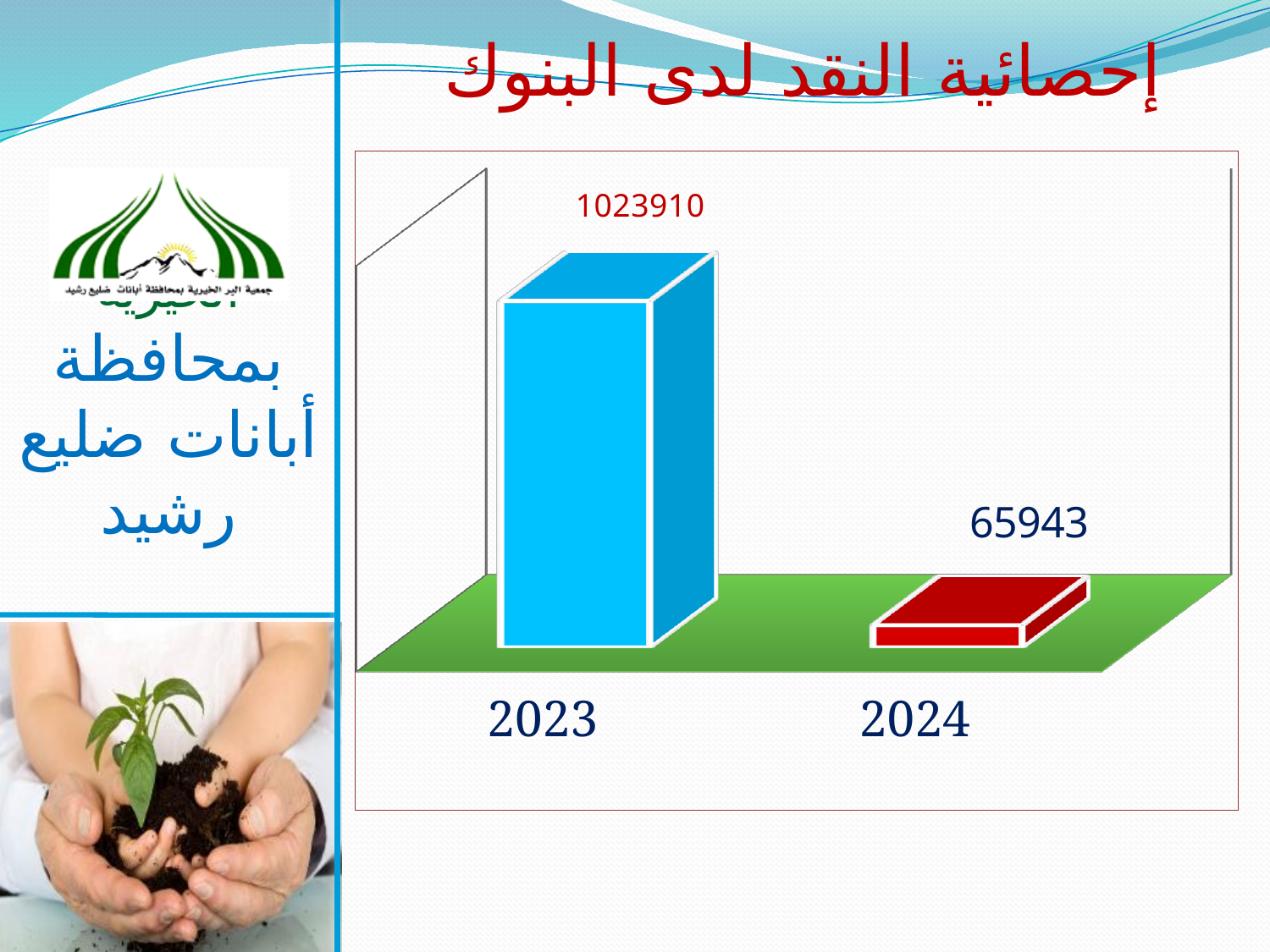
Do the values rise or fall from 2023 to 2024? fall What kind of chart is shown on the slide? bar chart Which year has the lowest value? 2024 What is the difference between the values for 2023 and 2024? 957967 Which is larger, the value for 2023 or the value for 2024? 2023 What is the value for 2024? 65943 How many categories are shown on the x axis? 2 Which year has the highest value? 2023 What is the title of the chart? إحصائية النقد لدى البنوك What is the value for 2023? 1023910 What colour is the bar for 2024? red